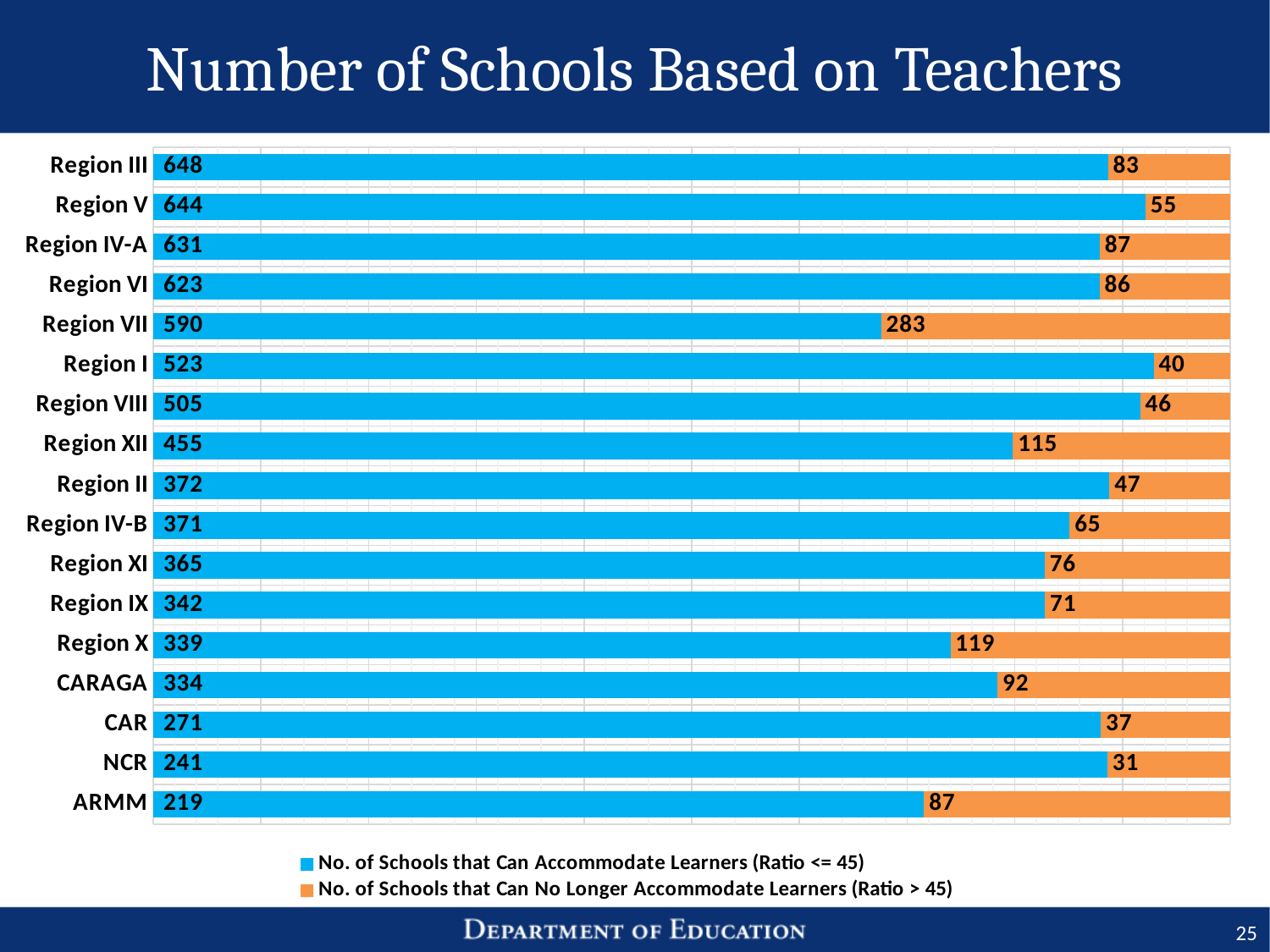
Which region has the highest number of schools that can no longer accommodate learners (Ratio > 45)? Region VII How many regions are shown in the chart? 17 How many schools in Region VII can accommodate learners (Ratio <= 45)? 590 Which has more schools that can no longer accommodate learners, Region VII or Region XII? Region VII What is the difference between the number of schools in Region VII that can accommodate learners and those that can no longer accommodate learners? 307 How many series does the legend list? 2 Which region has the lowest number of schools that can accommodate learners (Ratio <= 45)? ARMM How many schools in Region XII can no longer accommodate learners (Ratio > 45)? 115 What is the total number of schools shown for Region III? 731 Which region has the lowest number of schools that can no longer accommodate learners (Ratio > 45)? NCR What type of chart is shown on the slide? Bar chart Which region has the highest number of schools that can accommodate learners (Ratio <= 45)? Region III